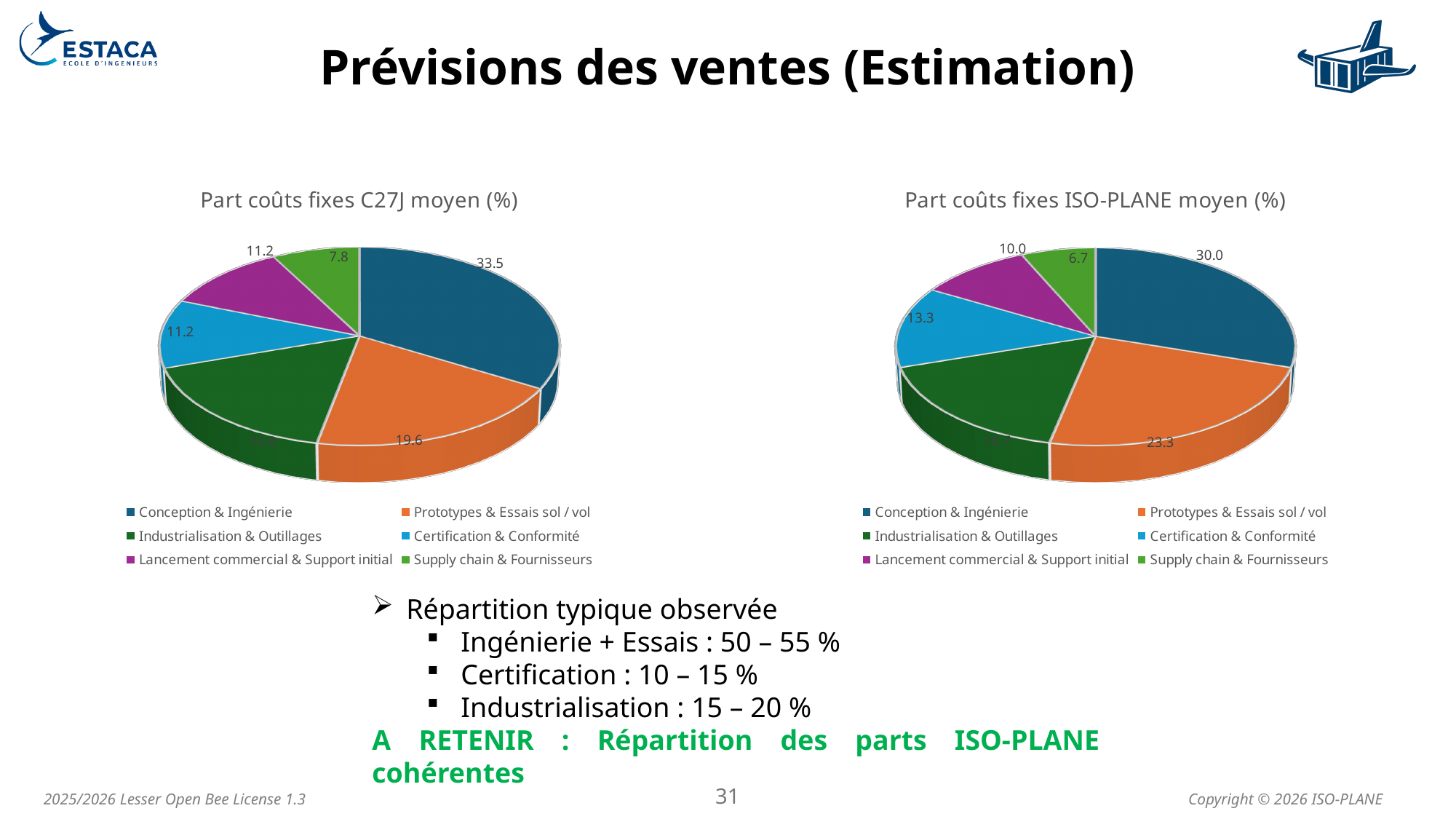
How many categories does the chart titled "Part coûts fixes C27J moyen (%)" show? 6 In the chart titled "Part coûts fixes ISO-PLANE moyen (%)", what is the difference between the values for Conception & Ingénierie and Prototypes & Essais sol / vol? 6.7 In the chart titled "Part coûts fixes C27J moyen (%)", which colour represents Prototypes & Essais sol / vol? Orange In the chart titled "Part coûts fixes ISO-PLANE moyen (%)", which category has the largest slice? Conception & Ingénierie In the chart titled "Part coûts fixes ISO-PLANE moyen (%)", what is the value for Certification & Conformité? 13.3 In the chart titled "Part coûts fixes C27J moyen (%)", what is the value for Conception & Ingénierie? 33.5 In the chart titled "Part coûts fixes C27J moyen (%)", what is the value for Supply chain & Fournisseurs? 7.8 In the chart titled "Part coûts fixes ISO-PLANE moyen (%)", which is larger: Certification & Conformité or Lancement commercial & Support initial? Certification & Conformité What kind of chart is the chart titled "Part coûts fixes ISO-PLANE moyen (%)"? Pie chart In the chart titled "Part coûts fixes C27J moyen (%)", which category has the smallest slice? Supply chain & Fournisseurs In the chart titled "Part coûts fixes C27J moyen (%)", what is the difference between the values for Conception & Ingénierie and Prototypes & Essais sol / vol? 13.9 In the chart titled "Part coûts fixes ISO-PLANE moyen (%)", what is the value for Prototypes & Essais sol / vol? 23.3